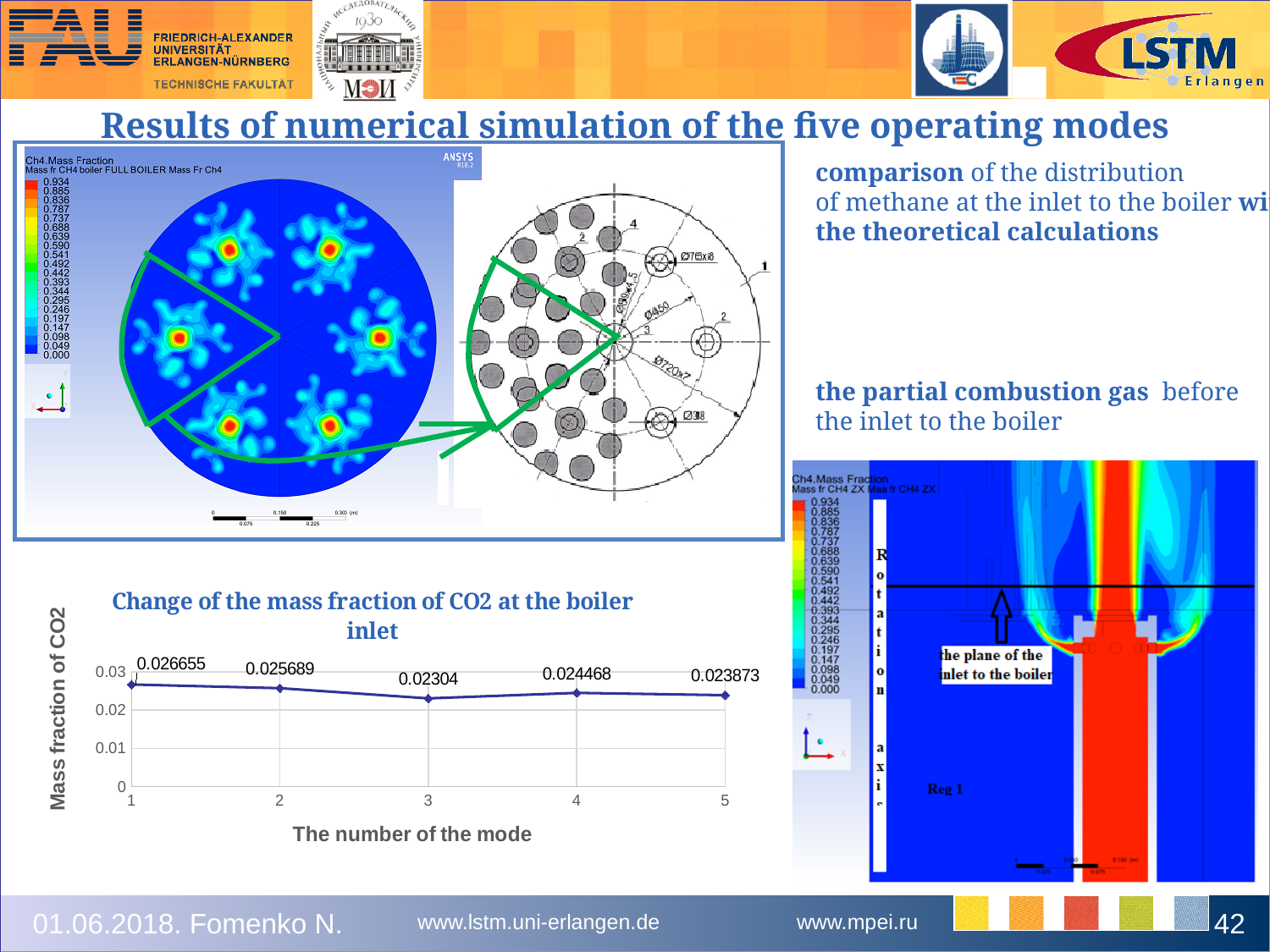
Which mode has the lowest mass fraction of CO2? 3 What kind of chart is used to show the change of the mass fraction of CO2? line chart What is the label of the x axis of the chart? The number of the mode Which mode has the highest mass fraction of CO2? 1 Does the mass fraction of CO2 rise or fall from mode 1 to mode 3? fall How many modes are plotted on the chart? 5 What is the mass fraction of CO2 for mode 3? 0.02304 What is the difference between the mass fraction of CO2 for mode 1 and mode 2? 0.000966 What is the mass fraction of CO2 for mode 1? 0.026655 Which has a larger mass fraction of CO2, mode 4 or mode 5? mode 4 Is the mass fraction of CO2 for mode 2 greater or less than 0.02? greater What is the mass fraction of CO2 for mode 5? 0.023873